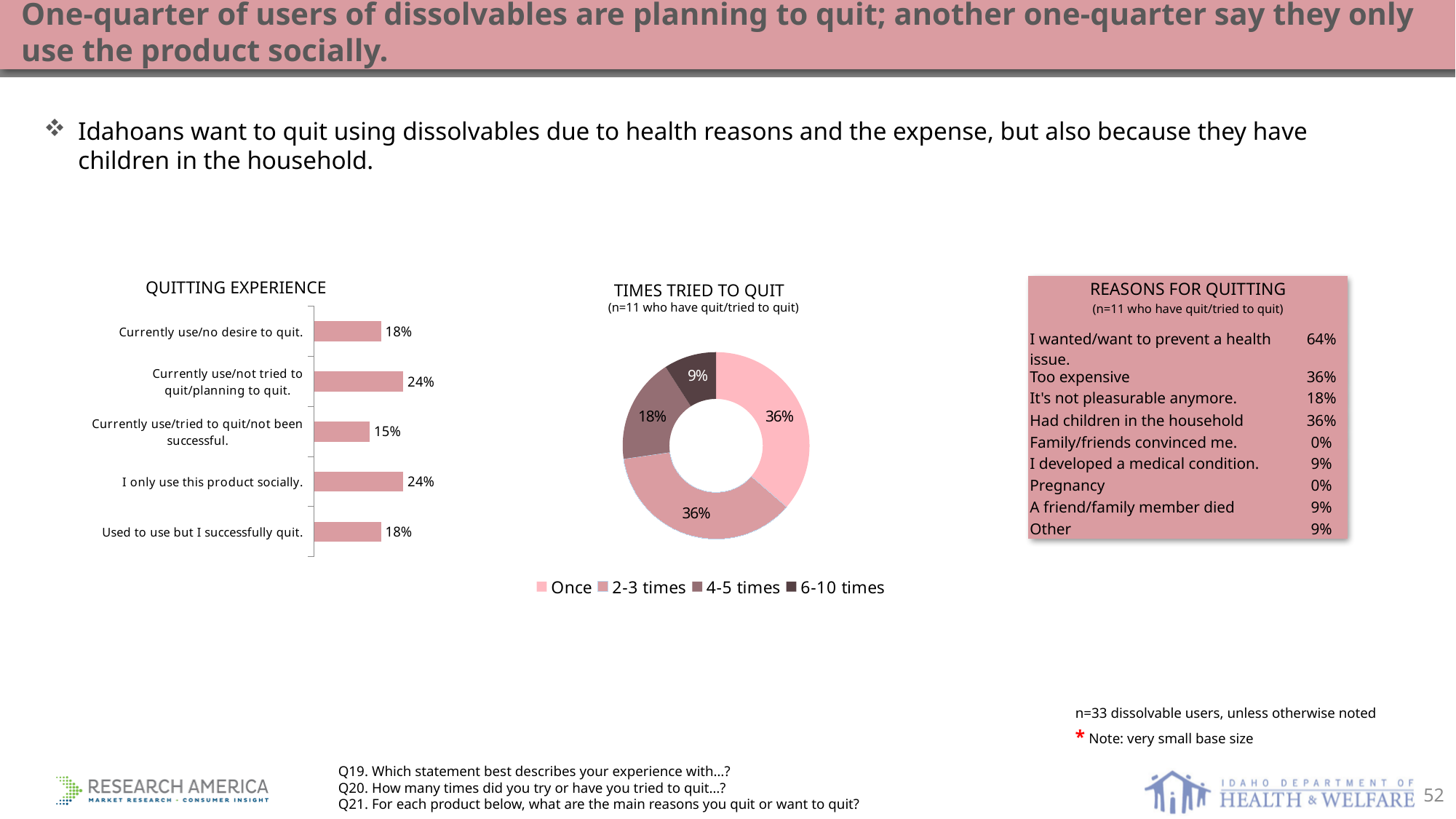
In the QUITTING EXPERIENCE chart, how many categories are plotted? 5 In the QUITTING EXPERIENCE chart, which category has the lowest value? Currently use/tried to quit/not been successful. In the QUITTING EXPERIENCE chart, what percentage is shown for "I only use this product socially."? 24% In the TIMES TRIED TO QUIT chart, what is the difference between the "Once" share and the "6-10 times" share? 27% In the QUITTING EXPERIENCE chart, what percentage is shown for "Currently use/tried to quit/not been successful."? 15% In the QUITTING EXPERIENCE chart, which is larger: "Used to use but I successfully quit." or "Currently use/tried to quit/not been successful."? Used to use but I successfully quit. What type of chart is the TIMES TRIED TO QUIT chart? Donut chart In the TIMES TRIED TO QUIT chart, what share is shown for "4-5 times"? 18% How many entries does the legend of the TIMES TRIED TO QUIT chart list? 4 What type of chart is the QUITTING EXPERIENCE chart? Bar chart In the QUITTING EXPERIENCE chart, what is the difference between "Currently use/not tried to quit/planning to quit." and "Currently use/no desire to quit."? 6% In the TIMES TRIED TO QUIT chart, which category has the smallest share? 6-10 times